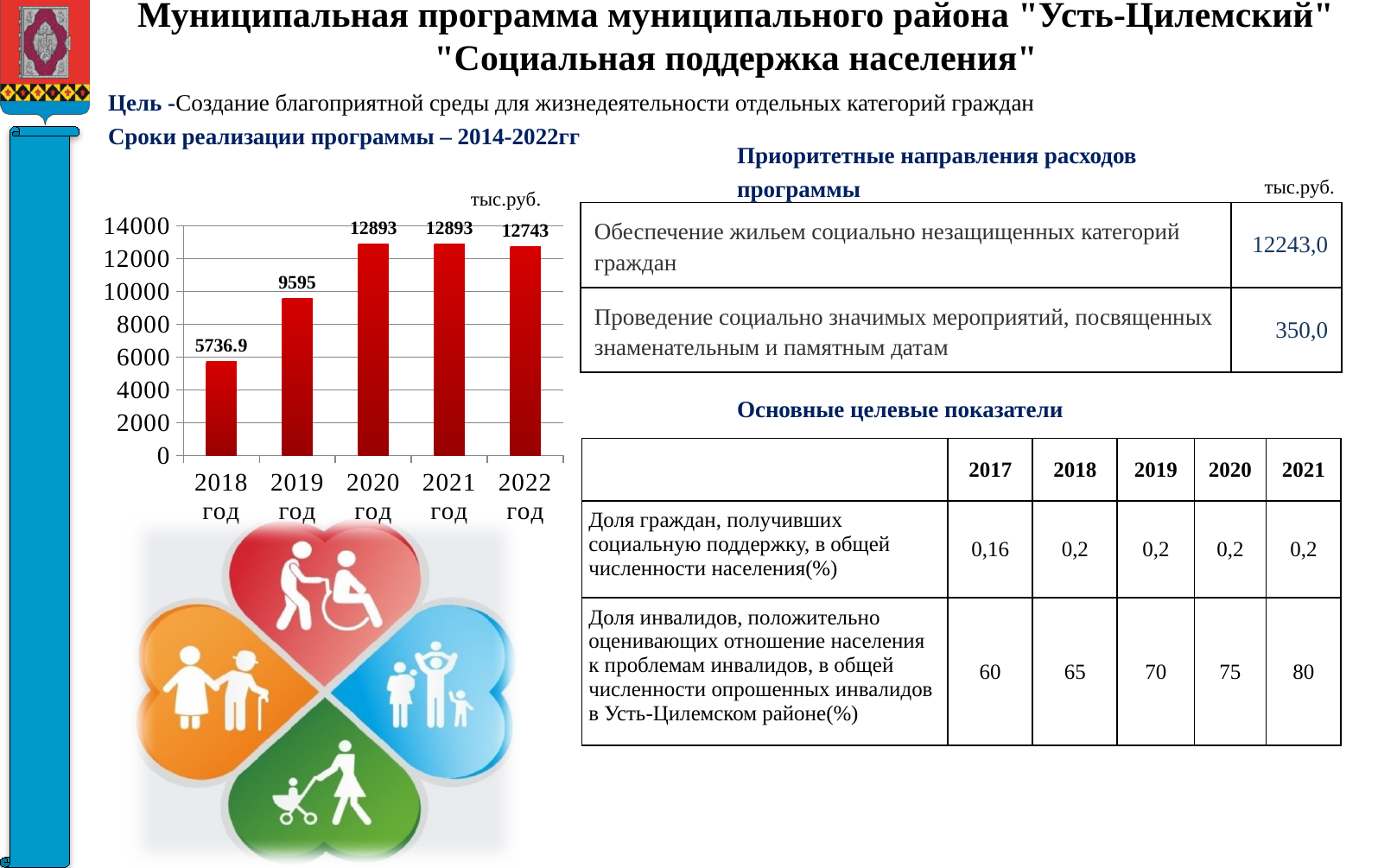
Which year has the lowest value in the bar chart? 2018 год What unit is indicated above the bar chart? тыс.руб. What is the difference between the values for 2021 год and 2022 год in the bar chart? 150 Is the value for 2019 год in the bar chart greater or less than 10000? less What is the value for 2019 год in the bar chart? 9595 Do the values in the bar chart rise or fall from 2018 год to 2020 год? rise How many years are shown in the bar chart? 5 What is the value for 2018 год in the bar chart? 5736.9 What is the difference between the values for 2019 год and 2018 год in the bar chart? 3858.1 Which is larger in the bar chart, the value for 2020 год or the value for 2022 год? 2020 год What is the value for 2022 год in the bar chart? 12743 What type of chart is shown on the slide? bar chart